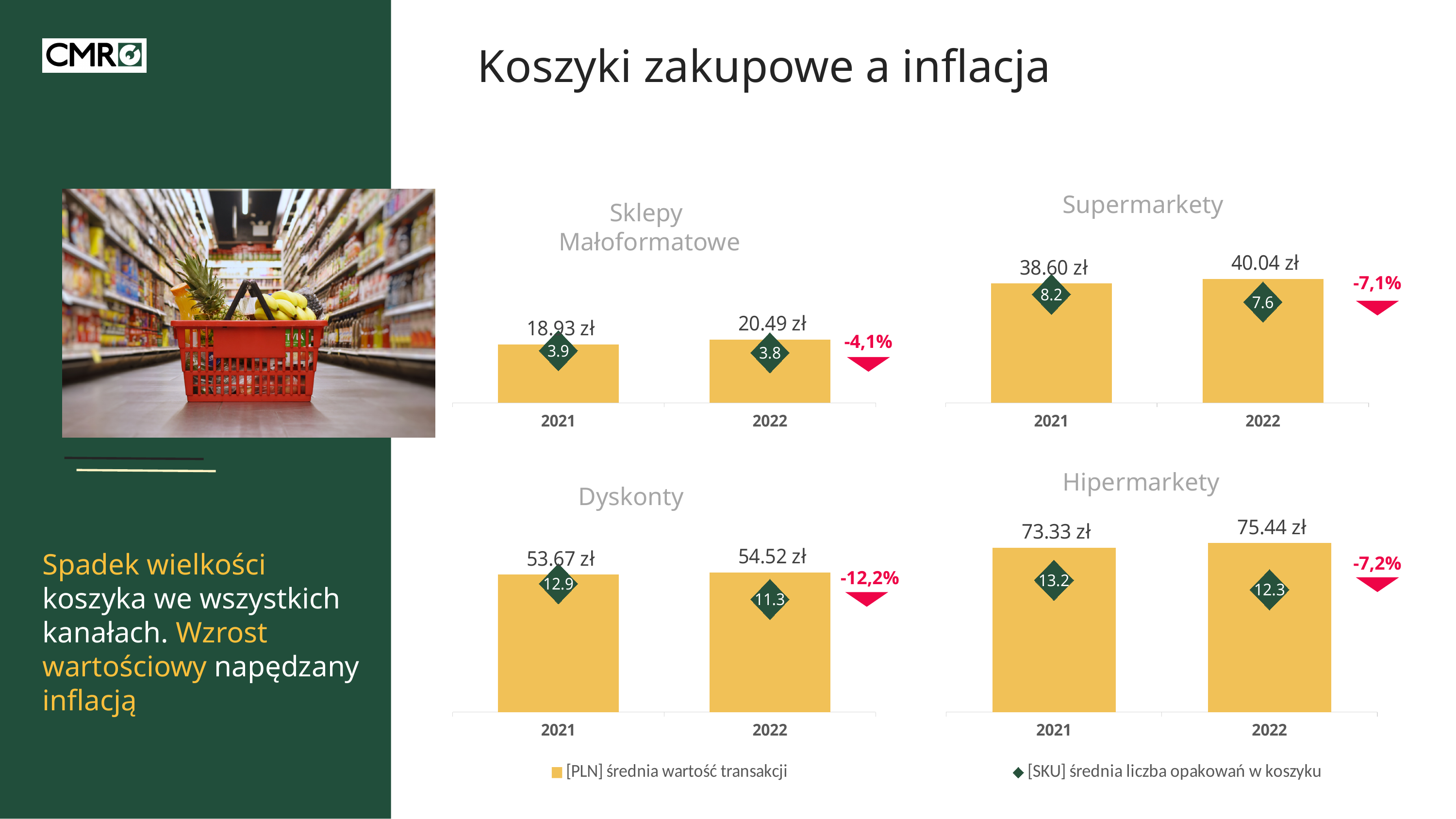
What kind of chart is used for the 'Hipermarkety' data? bar chart In the 'Supermarkety' chart, what is the average number of packages in the basket (SKU) in 2021? 8.2 In the 'Hipermarkety' chart, what is the SKU value for 2022? 12.3 How many years (categories) are shown on the x axis of the 'Dyskonty' chart? 2 In the 'Sklepy Małoformatowe' chart, what is the average transaction value in 2022? 20.49 zł How many series does the shared legend at the bottom of the slide list? 2 What percentage change is shown in red next to the 'Dyskonty' chart? -12,2% In the 'Supermarkety' chart, does the average transaction value rise or fall from 2021 to 2022? rise In the 'Sklepy Małoformatowe' chart, does the SKU value rise or fall from 2021 to 2022? fall In the 'Dyskonty' chart, which year has the higher SKU value, 2021 or 2022? 2021 In the 'Hipermarkety' chart, what is the difference in average transaction value between 2022 and 2021? 2.11 zł In the 'Dyskonty' chart, what is the average transaction value in 2021? 53.67 zł